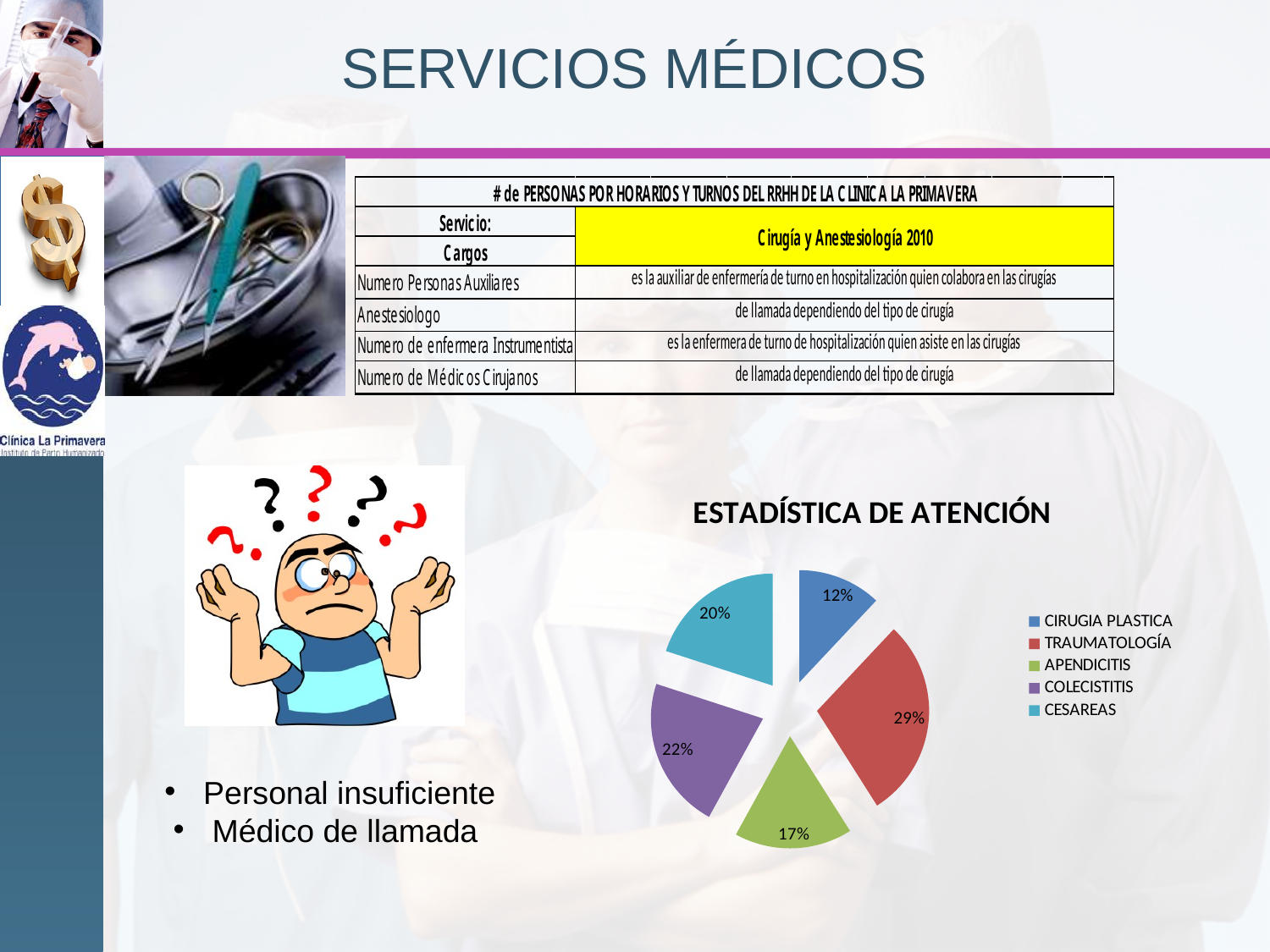
In the ESTADÍSTICA DE ATENCIÓN pie chart, which category has the smallest share? CIRUGIA PLASTICA What kind of chart is shown under the title ESTADÍSTICA DE ATENCIÓN? pie chart In the ESTADÍSTICA DE ATENCIÓN pie chart, what share does CESAREAS have? 20% In the ESTADÍSTICA DE ATENCIÓN pie chart, what share does APENDICITIS have? 17% In the ESTADÍSTICA DE ATENCIÓN pie chart, what is the difference between the shares of TRAUMATOLOGÍA and APENDICITIS? 12% How many categories does the ESTADÍSTICA DE ATENCIÓN pie chart show? 5 In the ESTADÍSTICA DE ATENCIÓN pie chart, what share does COLECISTITIS have? 22% In the ESTADÍSTICA DE ATENCIÓN pie chart, which category has the largest share? TRAUMATOLOGÍA In the ESTADÍSTICA DE ATENCIÓN pie chart, which has a larger share, COLECISTITIS or CESAREAS? COLECISTITIS In the ESTADÍSTICA DE ATENCIÓN pie chart, what colour is the TRAUMATOLOGÍA slice? red